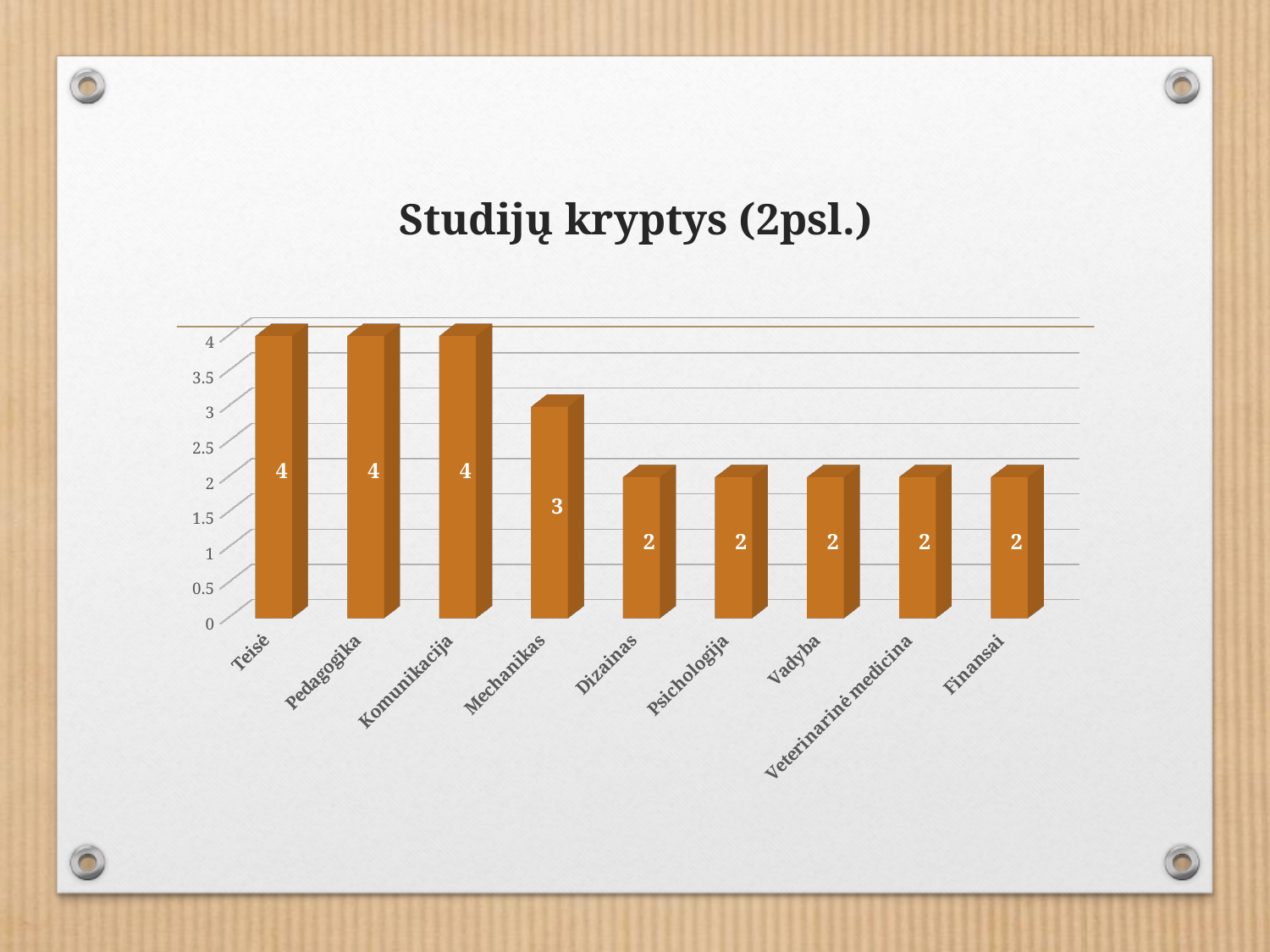
Which is larger, the value for Mechanikas or the value for Psichologija? Mechanikas What kind of chart is shown on the slide? Bar chart What is the value for Finansai? 2 What is the difference between the values for Pedagogika and Mechanikas? 1 Which is larger, the value for Vadyba or the value for Teisė? Teisė How many categories are shown on the x axis? 9 What is the value for Teisė? 4 What is the title of the chart? Studijų kryptys (2psl.) What is the value for Mechanikas? 3 What is the value for Veterinarinė medicina? 2 What is the difference between the values for Komunikacija and Dizainas? 2 Do the values rise or fall from left to right along the x axis? Fall